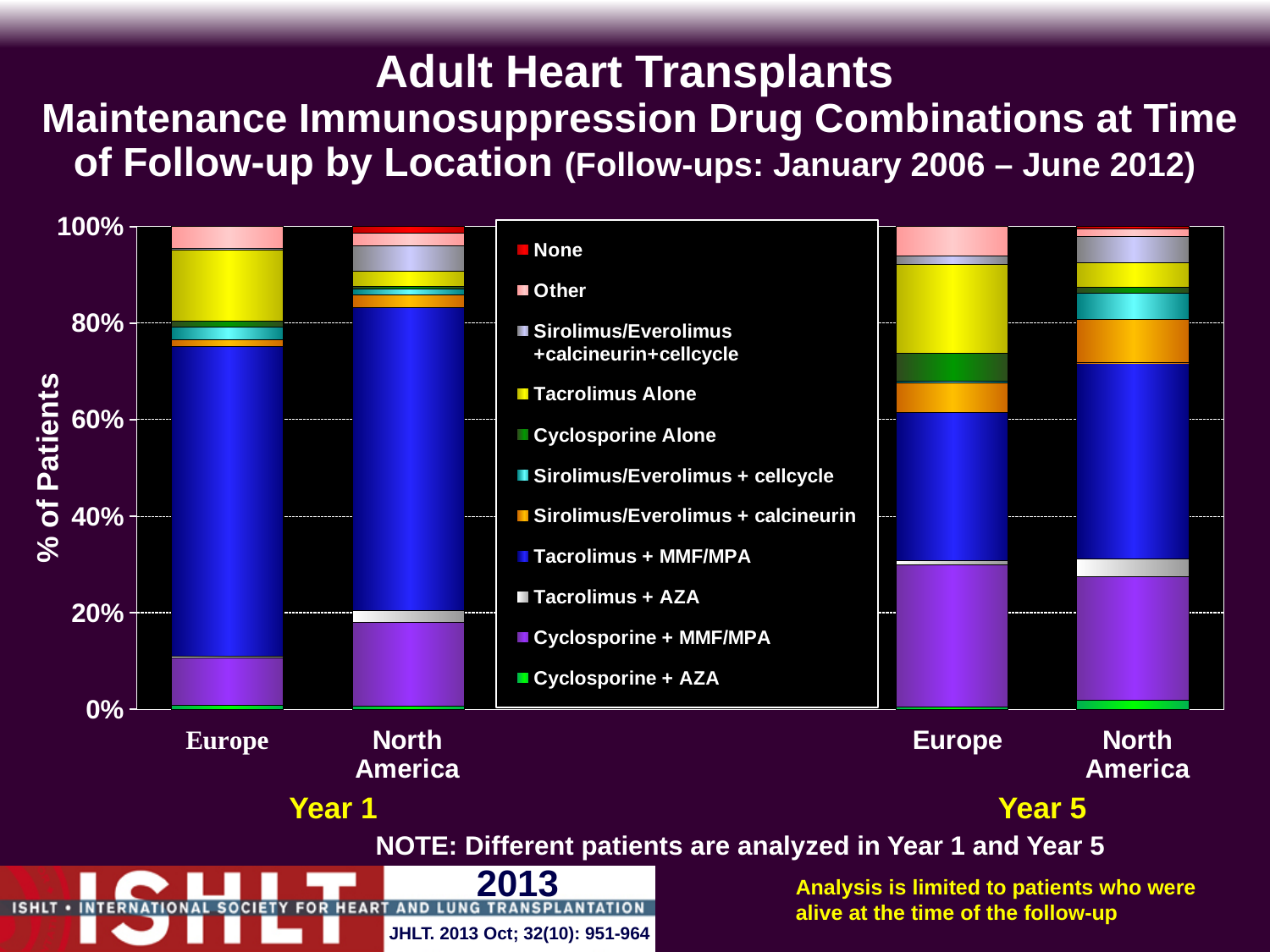
How many stacked bars are plotted on the chart? 4 Which has the larger Tacrolimus + MMF/MPA segment: Europe in Year 1 or Europe in Year 5? Europe in Year 1 Which has the larger Cyclosporine + MMF/MPA segment: Europe in Year 1 or Europe in Year 5? Europe in Year 5 Is the Cyclosporine + MMF/MPA segment for Europe in Year 5 greater or less than 20%? greater How many series does the legend list? 11 Is the Tacrolimus + MMF/MPA segment for North America in Year 5 greater or less than 20%? greater What is the label of the y axis? % of Patients Which has the larger Sirolimus/Everolimus + calcineurin segment: North America in Year 1 or North America in Year 5? North America in Year 5 Which legend entry is shown in red? None What kind of chart is shown on the slide? Stacked bar chart Is the Tacrolimus + MMF/MPA segment for Europe in Year 1 greater or less than 40%? greater